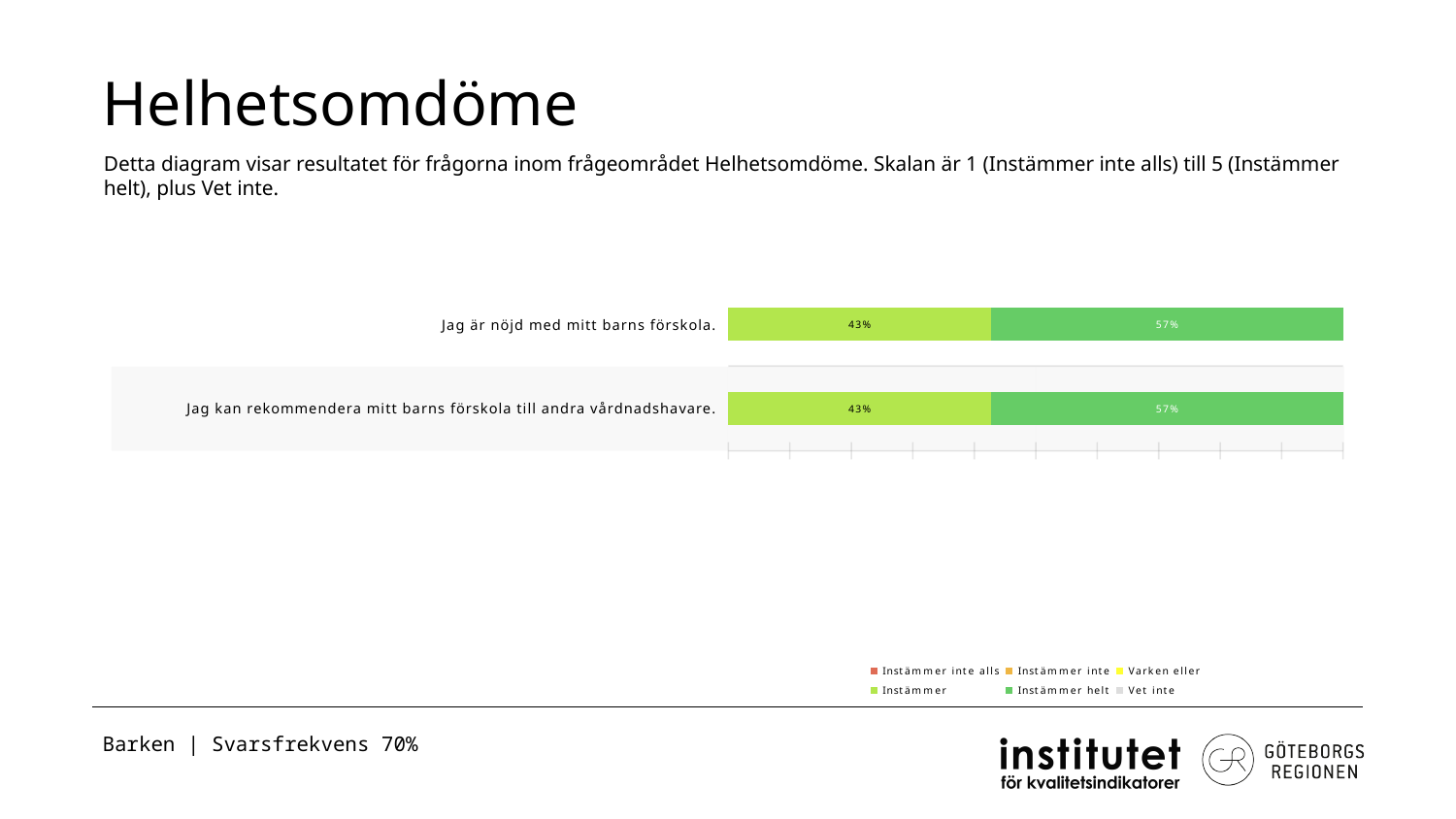
What is the total of the labelled segments in the bar for "Jag är nöjd med mitt barns förskola."? 100% What is the title of the slide containing the chart? Helhetsomdöme What is the value of "Instämmer helt" for "Jag kan rekommendera mitt barns förskola till andra vårdnadshavare."? 57% Which legend entry is shown in the darker green colour? Instämmer helt How many series does the legend list? 6 What is the difference between "Instämmer helt" and "Instämmer" for "Jag kan rekommendera mitt barns förskola till andra vårdnadshavare."? 14% What kind of chart is shown on the slide? Stacked bar chart What is the value of "Instämmer" for "Jag kan rekommendera mitt barns förskola till andra vårdnadshavare."? 43% What is the value of "Instämmer" for "Jag är nöjd med mitt barns förskola."? 43% How many categories (questions) are plotted in the chart? 2 For "Jag är nöjd med mitt barns förskola.", which is larger: "Instämmer" or "Instämmer helt"? Instämmer helt What is the value of "Instämmer helt" for "Jag är nöjd med mitt barns förskola."? 57%